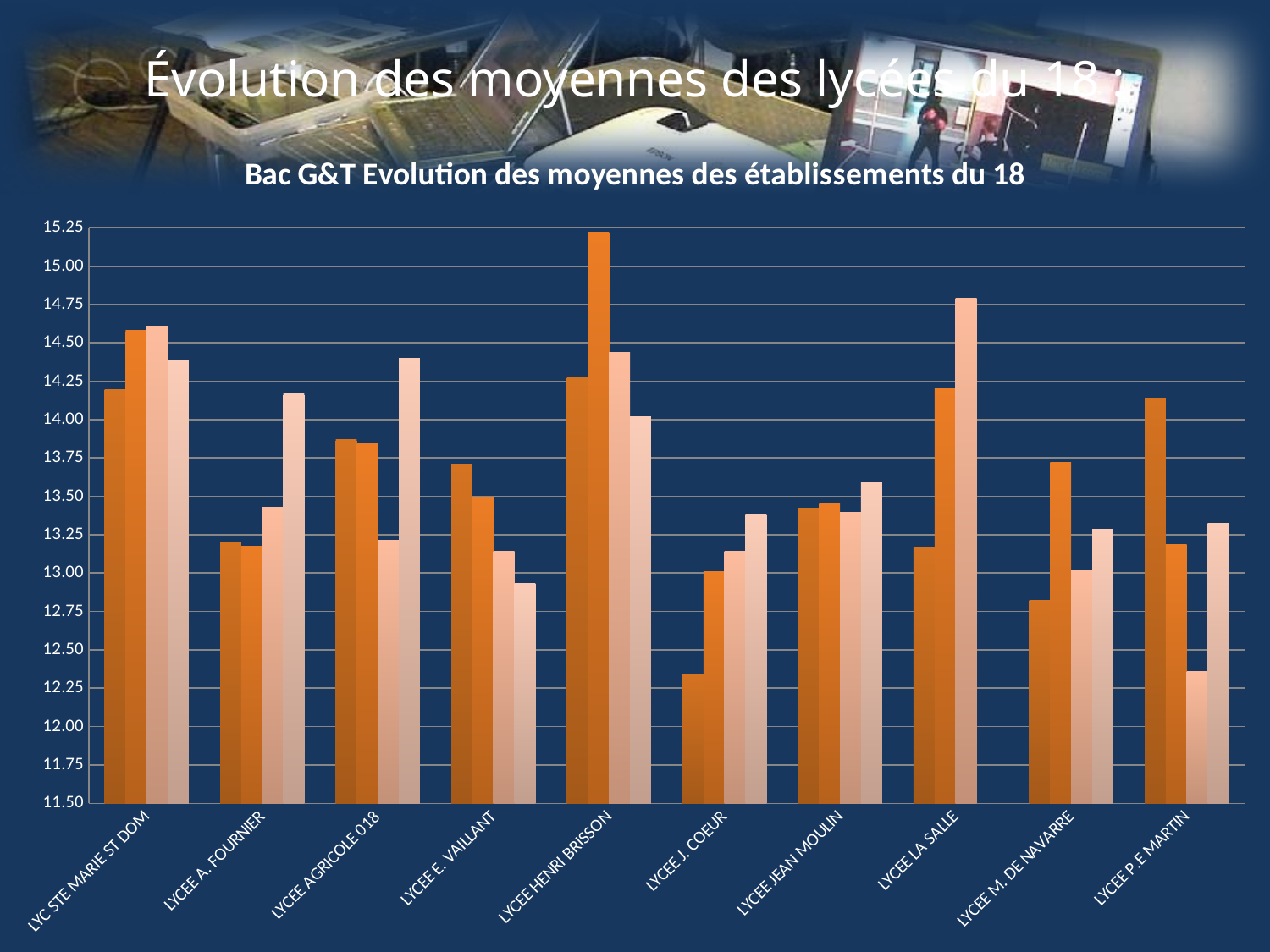
Is the first bar for LYCEE M. DE NAVARRE greater or less than 13.00? less How many lycées (categories) are shown along the x axis of the chart? 10 What kind of chart is shown on the slide? bar chart Is the lowest bar for LYCEE J. COEUR greater or less than 12.50? less Is the last bar for LYCEE AGRICOLE 018 greater or less than 14.25? greater What is the highest value shown on the chart's y axis? 15.25 How many bars are plotted for each lycée in the chart? 4 Which lycée has the tallest bar in the chart? LYCEE HENRI BRISSON What is the title of the chart? Bac G&T Evolution des moyennes des établissements du 18 Which is taller: the tallest bar for LYCEE LA SALLE or the tallest bar for LYC STE MARIE ST DOM? LYCEE LA SALLE